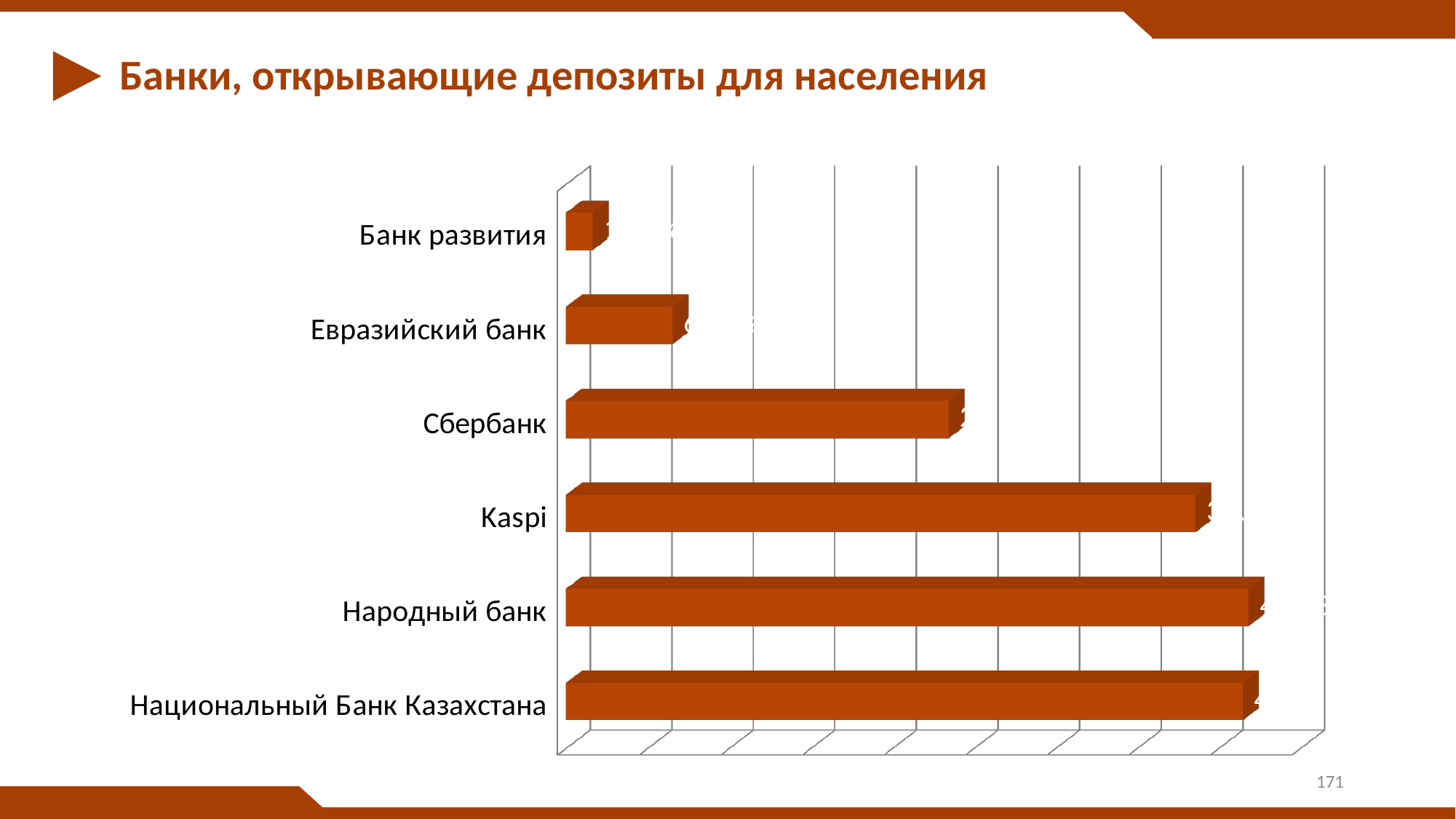
Which has the larger value, Сбербанк or Евразийский банк? Сбербанк What kind of chart is shown on the slide? bar chart How many banks (categories) are shown in the chart? 6 Which has the larger value, Национальный Банк Казахстана or Сбербанк? Национальный Банк Казахстана Which has the larger value, Kaspi or Сбербанк? Kaspi Which bank has the lowest value in the chart? Банк развития What colour are the bars in the chart? orange-brown What is the title of the slide containing the chart? Банки, открывающие депозиты для населения